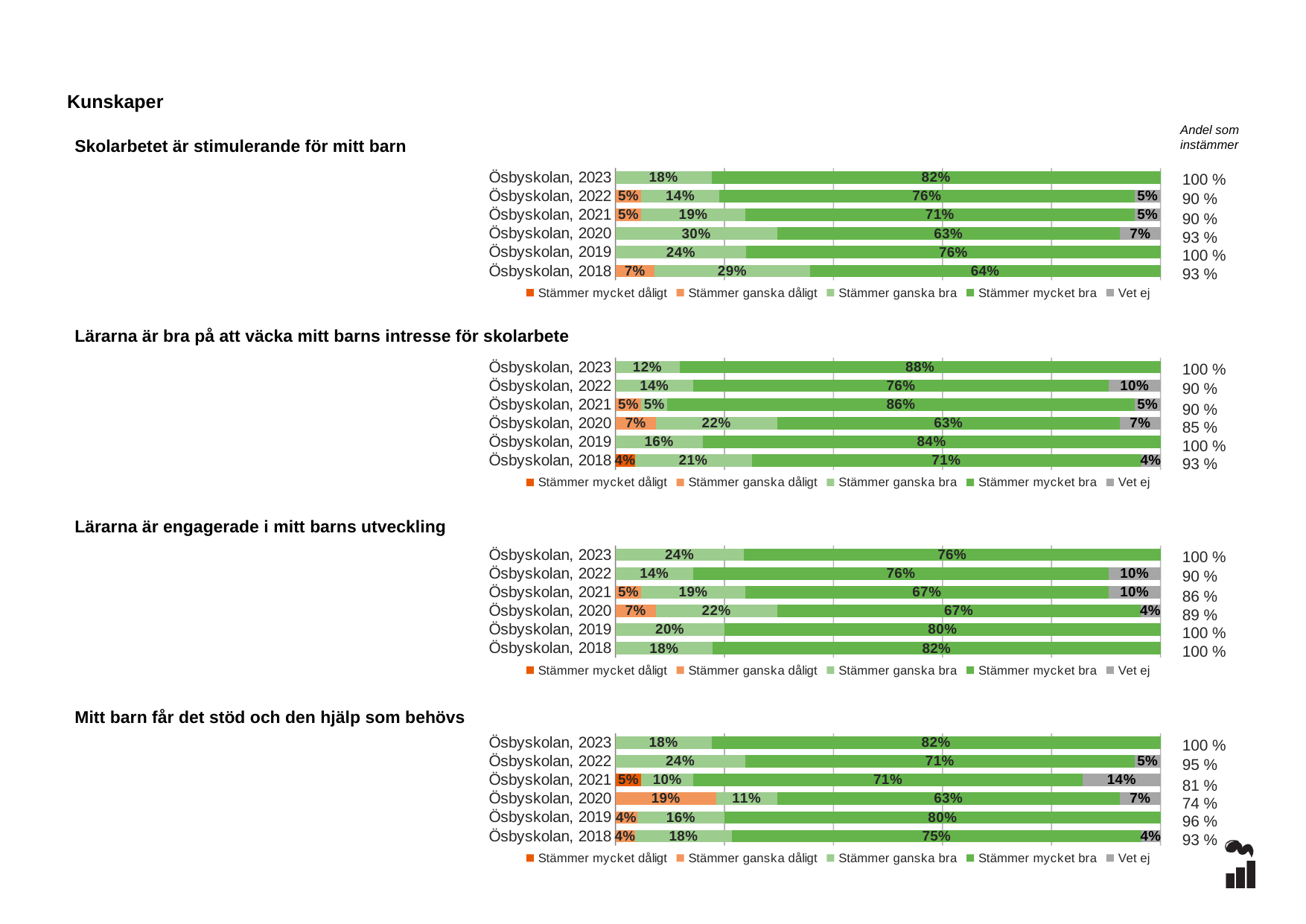
In the chart 'Lärarna är bra på att väcka mitt barns intresse för skolarbete', what is the 'Vet ej' value for Ösbyskolan, 2022? 10% In the chart 'Mitt barn får det stöd och den hjälp som behövs', what is the 'Andel som instämmer' value for Ösbyskolan, 2021? 81 % How many categories (years) are shown in the chart 'Lärarna är engagerade i mitt barns utveckling'? 6 How many series does the legend list for the chart 'Skolarbetet är stimulerande för mitt barn'? 5 In the chart 'Lärarna är engagerade i mitt barns utveckling', what is the difference between the 'Stämmer mycket bra' values for Ösbyskolan, 2018 and Ösbyskolan, 2021? 15% In the chart 'Lärarna är bra på att väcka mitt barns intresse för skolarbete', which year has the highest 'Stämmer mycket bra' value? Ösbyskolan, 2023 What kind of chart is used for 'Mitt barn får det stöd och den hjälp som behövs'? Stacked bar chart In the chart 'Lärarna är engagerade i mitt barns utveckling', which is larger: the 'Stämmer ganska bra' value for Ösbyskolan, 2023 or for Ösbyskolan, 2022? Ösbyskolan, 2023 In the chart 'Skolarbetet är stimulerande för mitt barn', what is the 'Stämmer mycket bra' value for Ösbyskolan, 2023? 82% In the chart 'Skolarbetet är stimulerande för mitt barn', what is the 'Stämmer ganska bra' value for Ösbyskolan, 2020? 30% In the chart 'Mitt barn får det stöd och den hjälp som behövs', what is the 'Stämmer ganska dåligt' value for Ösbyskolan, 2020? 19% In the chart 'Mitt barn får det stöd och den hjälp som behövs', which year has the lowest 'Stämmer mycket bra' value? Ösbyskolan, 2020